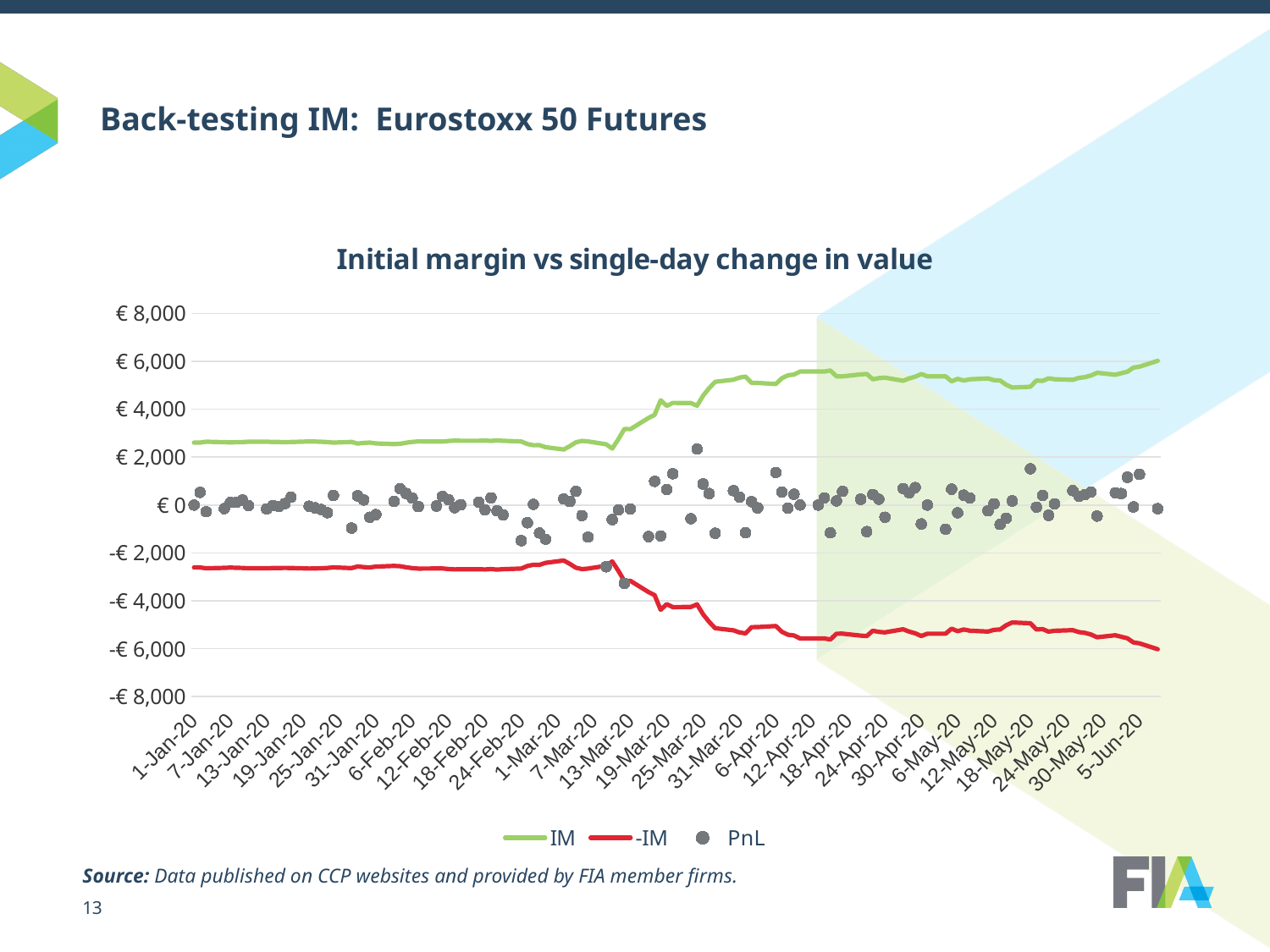
What are the three series listed in the legend? IM, -IM, PnL Which is larger, the IM value on 1-Jan-20 or the IM value on 5-Jun-20? 5-Jun-20 What is the title of the chart? Initial margin vs single-day change in value Does the -IM line rise or fall from 1-Jan-20 to 5-Jun-20? Fall Is the IM value on 5-Jun-20 greater or less than € 4,000? greater Is the IM value on 1-Jan-20 greater or less than € 4,000? less What kind of chart is shown on the slide? Line chart with scatter points Is the IM value on 1-Jan-20 greater or less than € 2,000? greater Does the IM line rise or fall from 1-Jan-20 to 5-Jun-20? Rise How many series does the legend list? 3